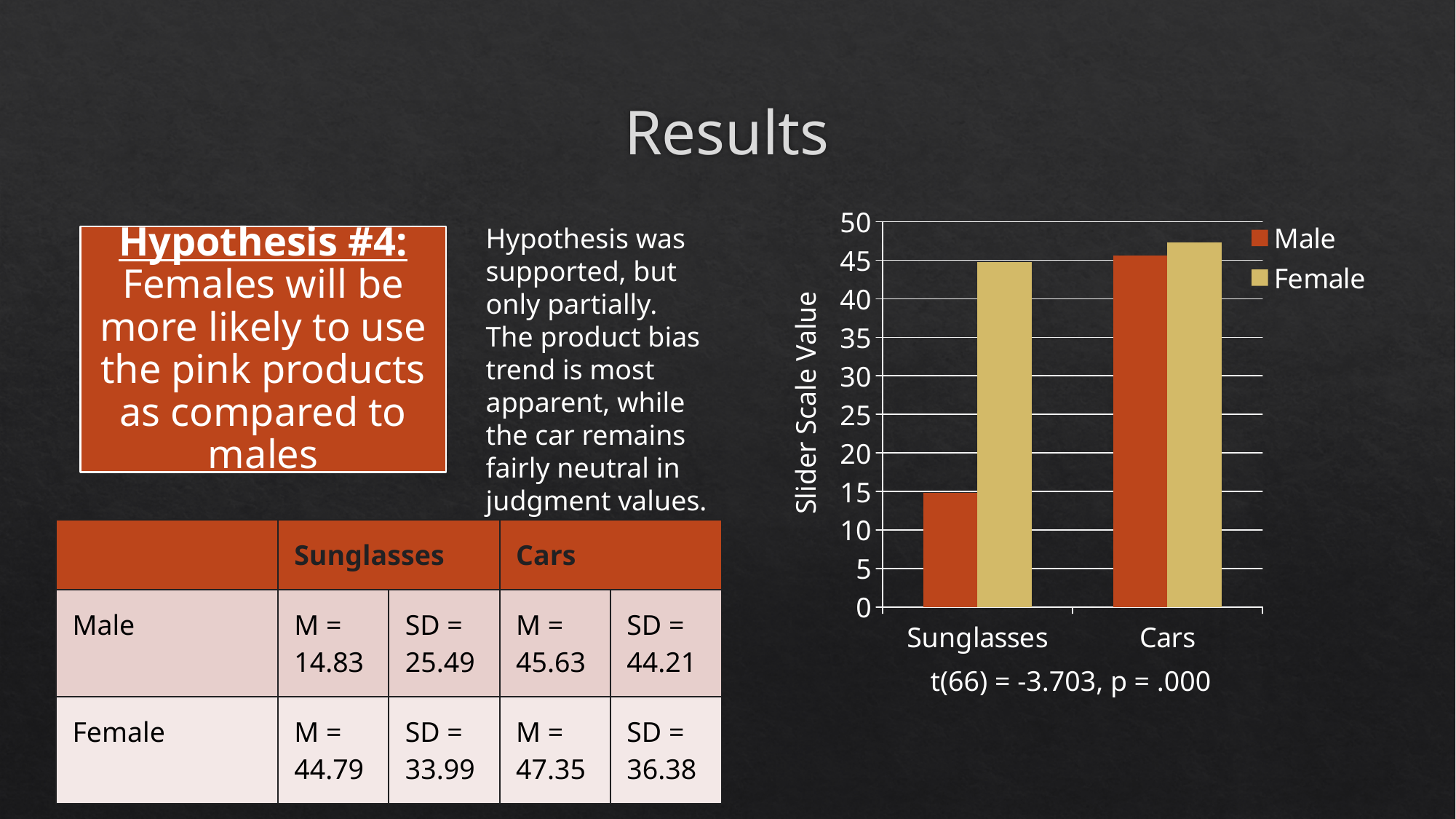
How many series does the chart legend list? 2 Is the Female value for Sunglasses greater or less than 40? greater What kind of chart is shown on the slide? bar chart Which bar in the chart is the lowest? Male, Sunglasses Is the Female value for Cars greater or less than 50? less Is the Male value for Cars greater or less than 40? greater Does the Male series rise or fall from Sunglasses to Cars? rise For Sunglasses, which series has the larger value, Male or Female? Female What is the label of the chart's vertical axis? Slider Scale Value What are the two series named in the chart legend? Male and Female How many categories are shown on the x axis of the chart? 2